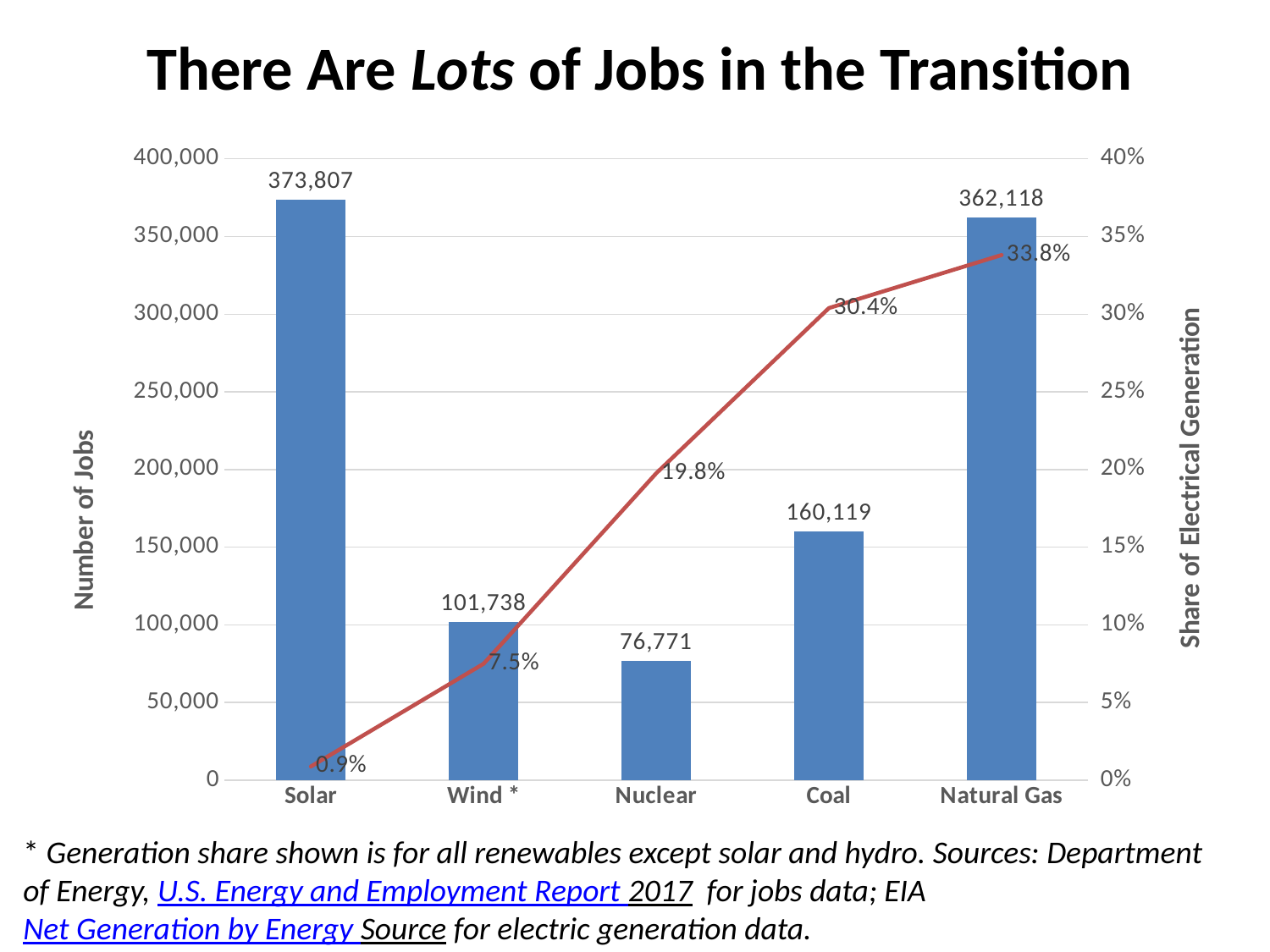
What is the difference in number of jobs between Solar and Natural Gas? 11,689 How many energy sources are shown on the x axis? 5 How much larger is the generation share of Natural Gas than that of Coal? 3.4% Which energy source has the lowest share of electrical generation? Solar What is the share of electrical generation shown for Coal? 30.4% Which has more jobs, Coal or Nuclear? Coal What share of electrical generation is shown for Natural Gas? 33.8% How many jobs does the chart show for Solar? 373,807 Which energy source has the highest number of jobs? Solar How many jobs are shown for Nuclear? 76,771 Does the share of electrical generation rise or fall from Solar to Natural Gas along the x axis? rise What is the title of the chart's left vertical axis? Number of Jobs